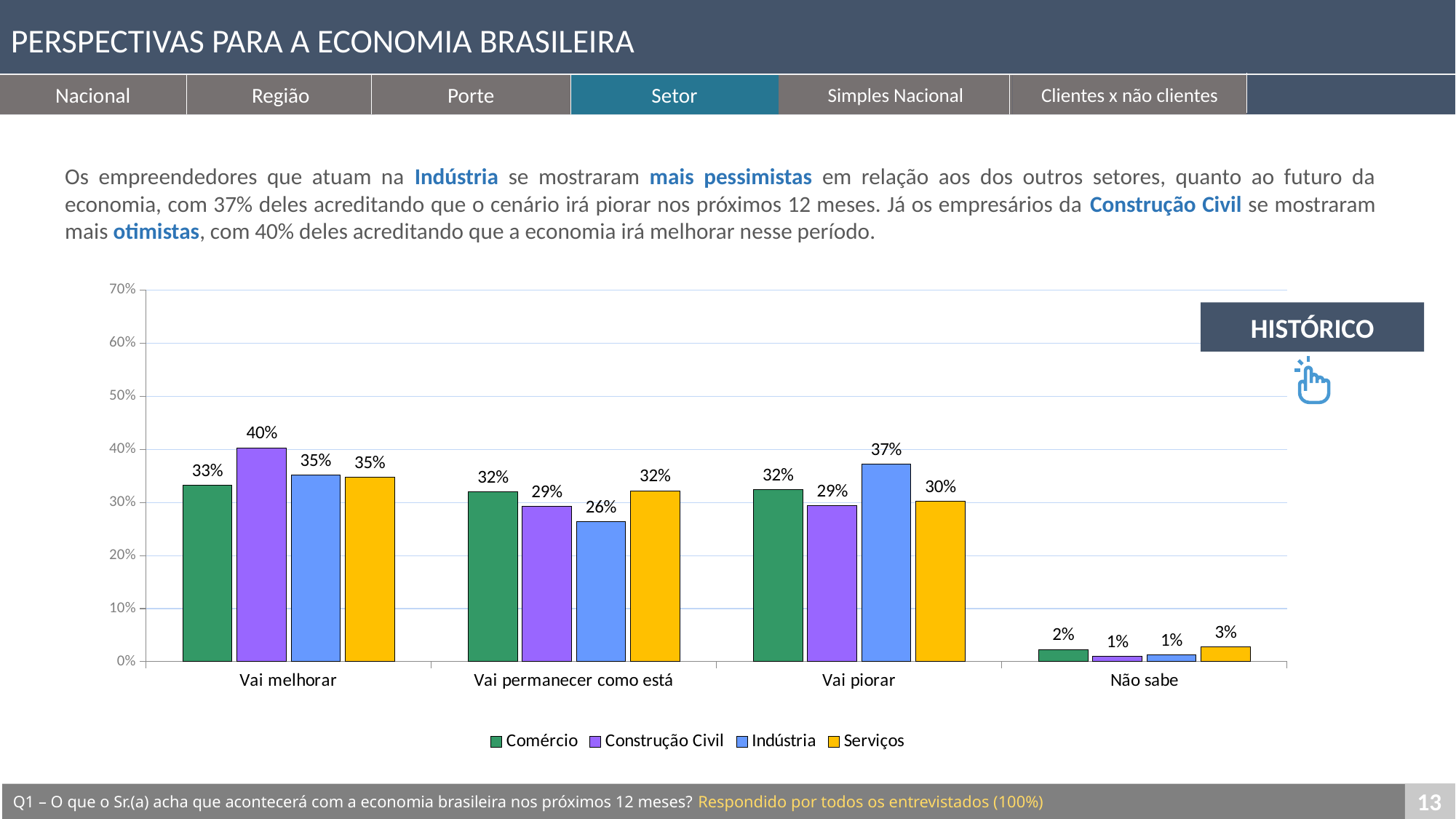
What is the difference between the Indústria and Construção Civil values in the 'Vai piorar' category? 8% What kind of chart is shown on the slide? Bar chart What is the value for Construção Civil in the 'Vai melhorar' category? 40% How many series does the legend list? 4 In the 'Vai permanecer como está' category, which is larger: Comércio or Construção Civil? Comércio What is the value for Indústria in the 'Vai piorar' category? 37% Which series has the highest value in the 'Vai melhorar' category? Construção Civil How many categories are shown on the x axis? 4 Which series has the lowest value in the 'Vai permanecer como está' category? Indústria What colour represents Serviços in the chart? Yellow What is the value for Serviços in the 'Não sabe' category? 3% What is the value for Indústria in the 'Vai permanecer como está' category? 26%